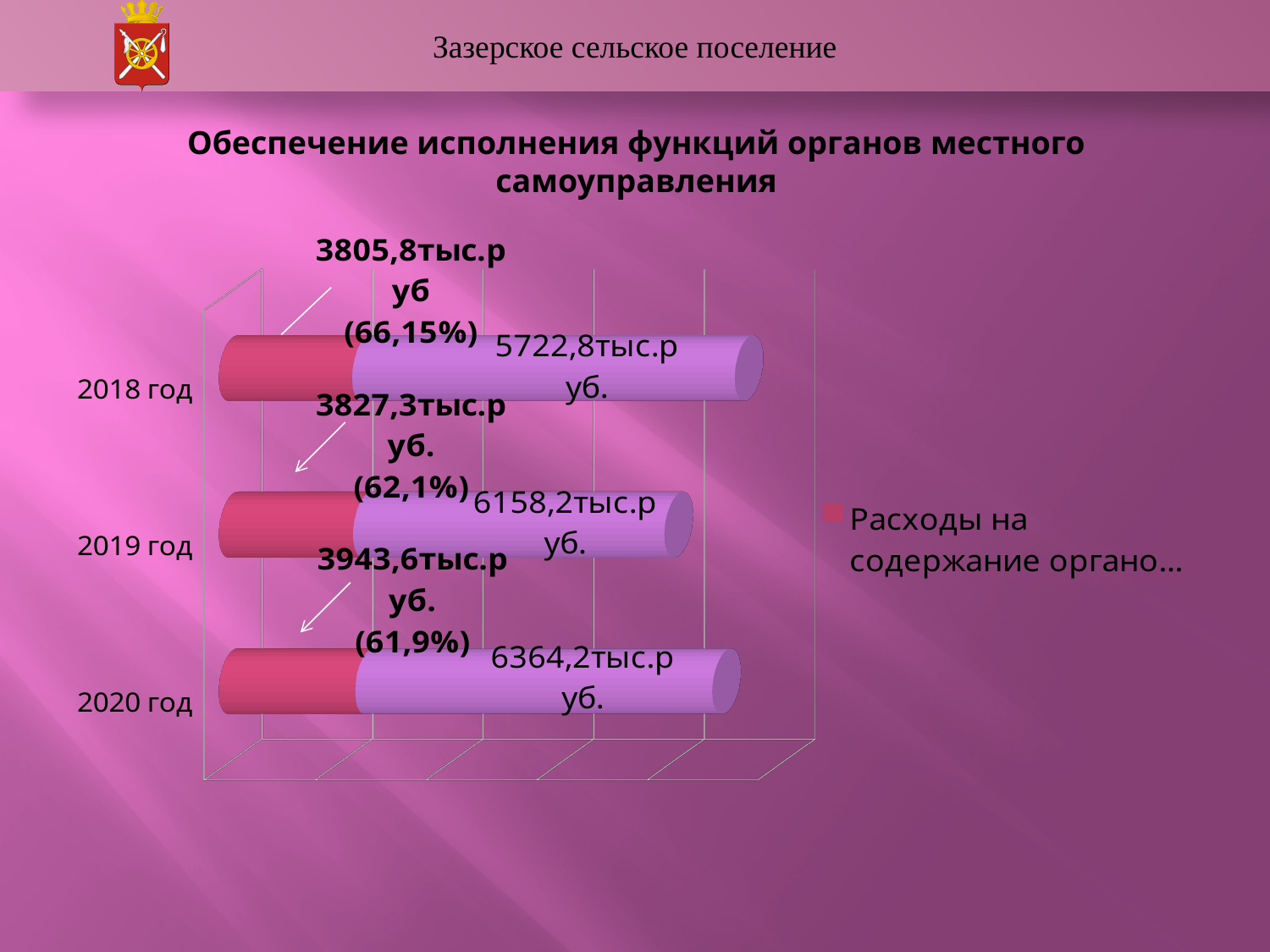
What percentage is shown in parentheses next to the red value for 2018 год? 66,15% How many years (categories) are shown on the chart? 3 What is the difference between the purple values for 2020 год and 2018 год? 641,4тыс.руб. What is the value printed on the purple segment for 2018 год? 5722,8тыс.руб. What is the value printed on the red segment for 2019 год? 3827,3тыс.руб. Do the red segment values rise or fall from 2018 год to 2020 год? rise What is the value printed on the red segment for 2018 год? 3805,8тыс.руб What is the value printed on the red segment for 2020 год? 3943,6тыс.руб. What is the value printed on the purple segment for 2019 год? 6158,2тыс.руб. What is the value printed on the purple segment for 2020 год? 6364,2тыс.руб. What kind of chart is shown on the slide? bar chart Which year has the highest value on the purple segment? 2020 год